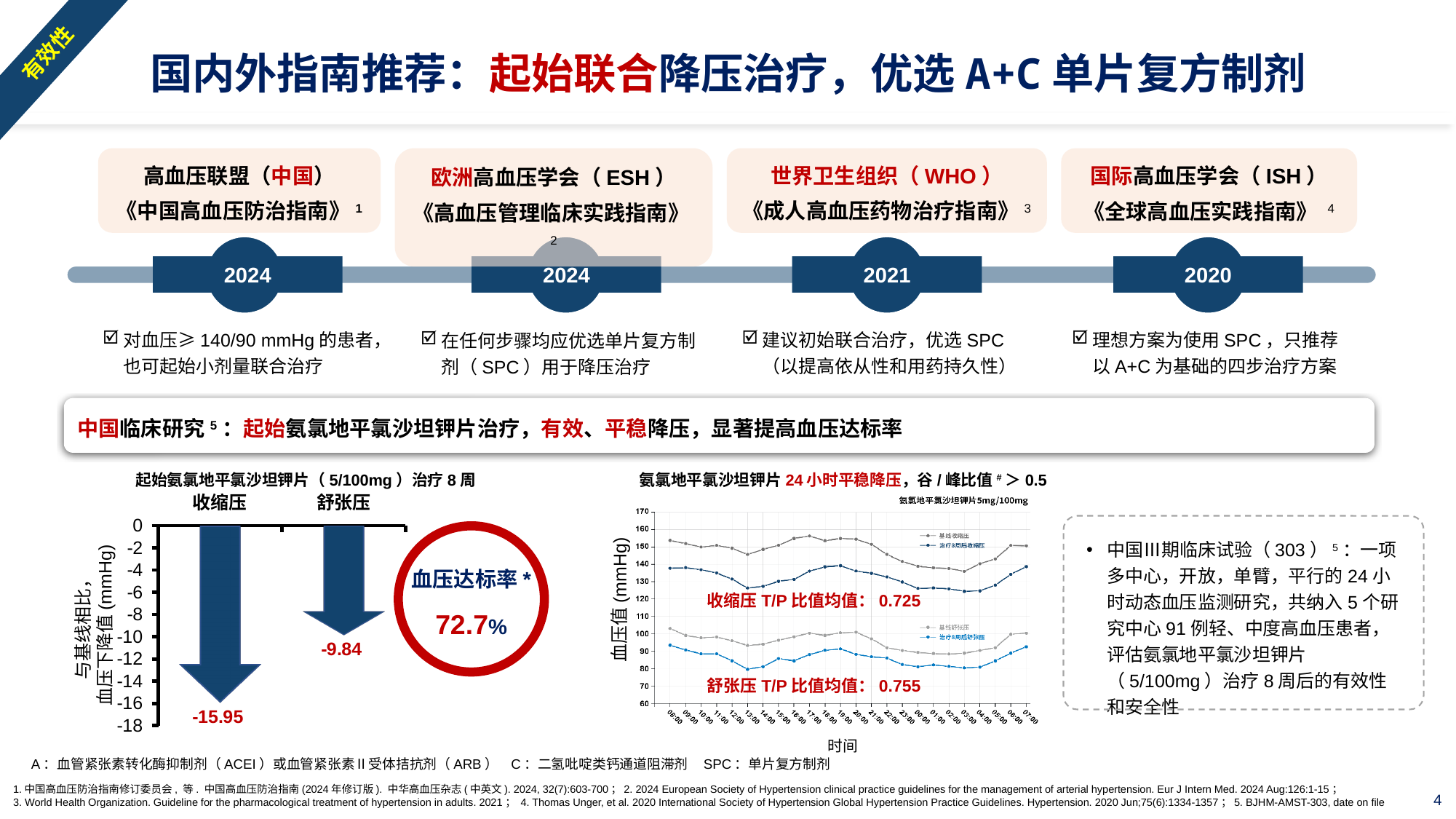
How many categories are plotted on the left chart? 2 On the right chart, is the 基线收缩压 line greater or less than 140 across the day? greater What kind of chart is the right chart (氨氯地平氯沙坦钾片 24小时平稳降压)? Line chart What is the y-axis label of the left chart? 与基线相比，血压下降值 (mmHg) What kind of chart is the left chart showing 收缩压 and 舒张压? Bar chart On the left chart, what is the difference between the 收缩压 and 舒张压 values? 6.11 On the left chart, which category shows the larger reduction from baseline, 收缩压 or 舒张压? 收缩压 On the right chart, what is the 舒张压 T/P 比值均值? 0.755 How many series does the legend of the right chart list? 4 On the left chart (起始氨氯地平氯沙坦钾片（5/100mg）治疗8周), what is the value for 舒张压? -9.84 On the right chart, what is the 收缩压 T/P 比值均值? 0.725 On the left chart (起始氨氯地平氯沙坦钾片（5/100mg）治疗8周), what is the value for 收缩压? -15.95